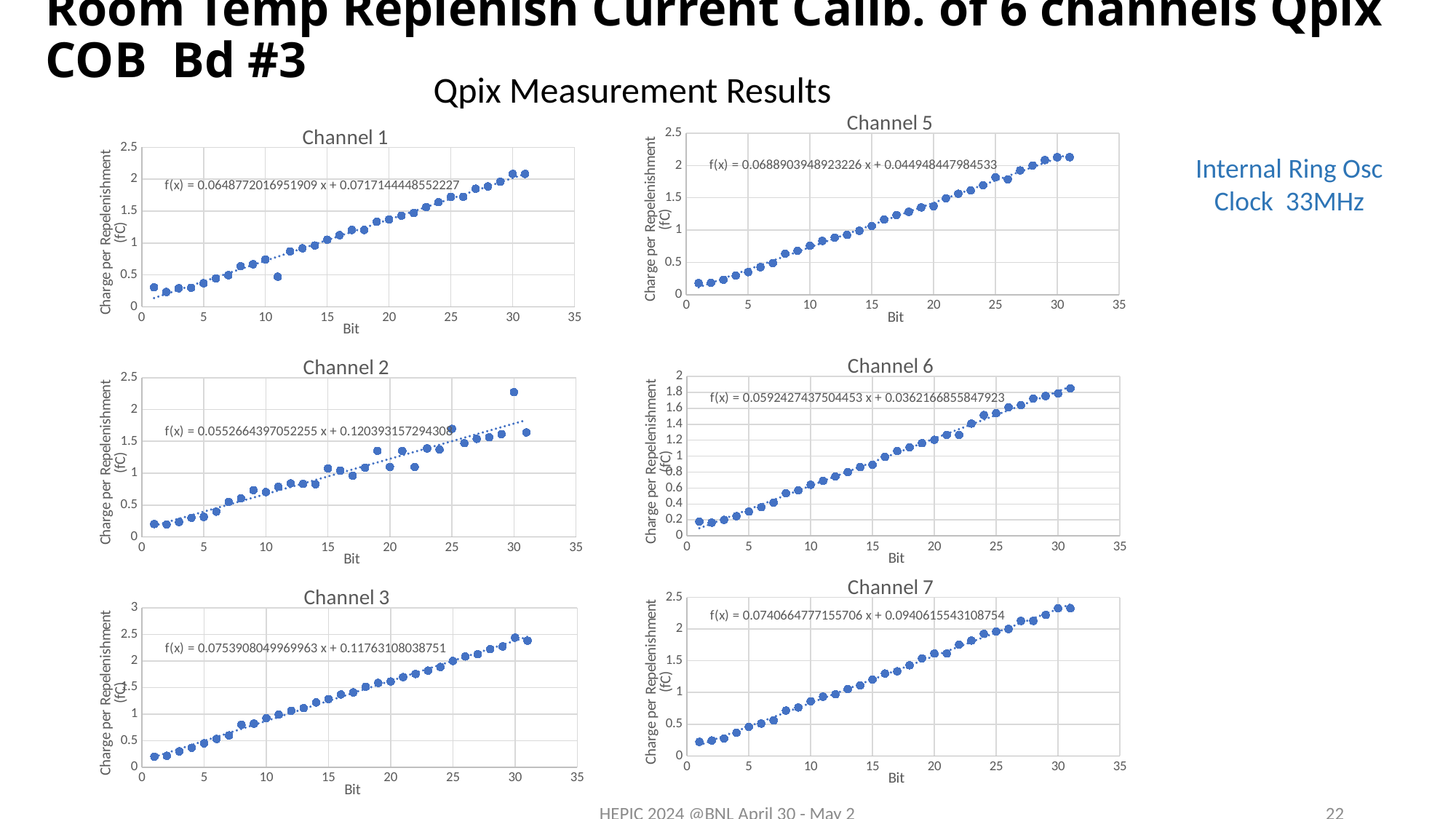
What is the slope in the trendline equation shown on the Channel 1 chart? 0.0648772016951909 In the Channel 7 chart, is the value at Bit 10 greater or less than 1? less In the Channel 1 chart, which is larger, the value at Bit 30 or the value at Bit 5? Bit 30 In the Channel 5 chart, is the value at Bit 5 greater or less than 0.5? less In the Channel 3 chart, is the value at Bit 30 greater or less than 2? greater In the Channel 5 chart, do the values rise or fall as Bit increases? rise What kind of chart is the Channel 1 chart? scatter chart What is the y-axis title of the Channel 7 chart? Charge per Repelenishment (fC) How many charts are shown on the slide? 6